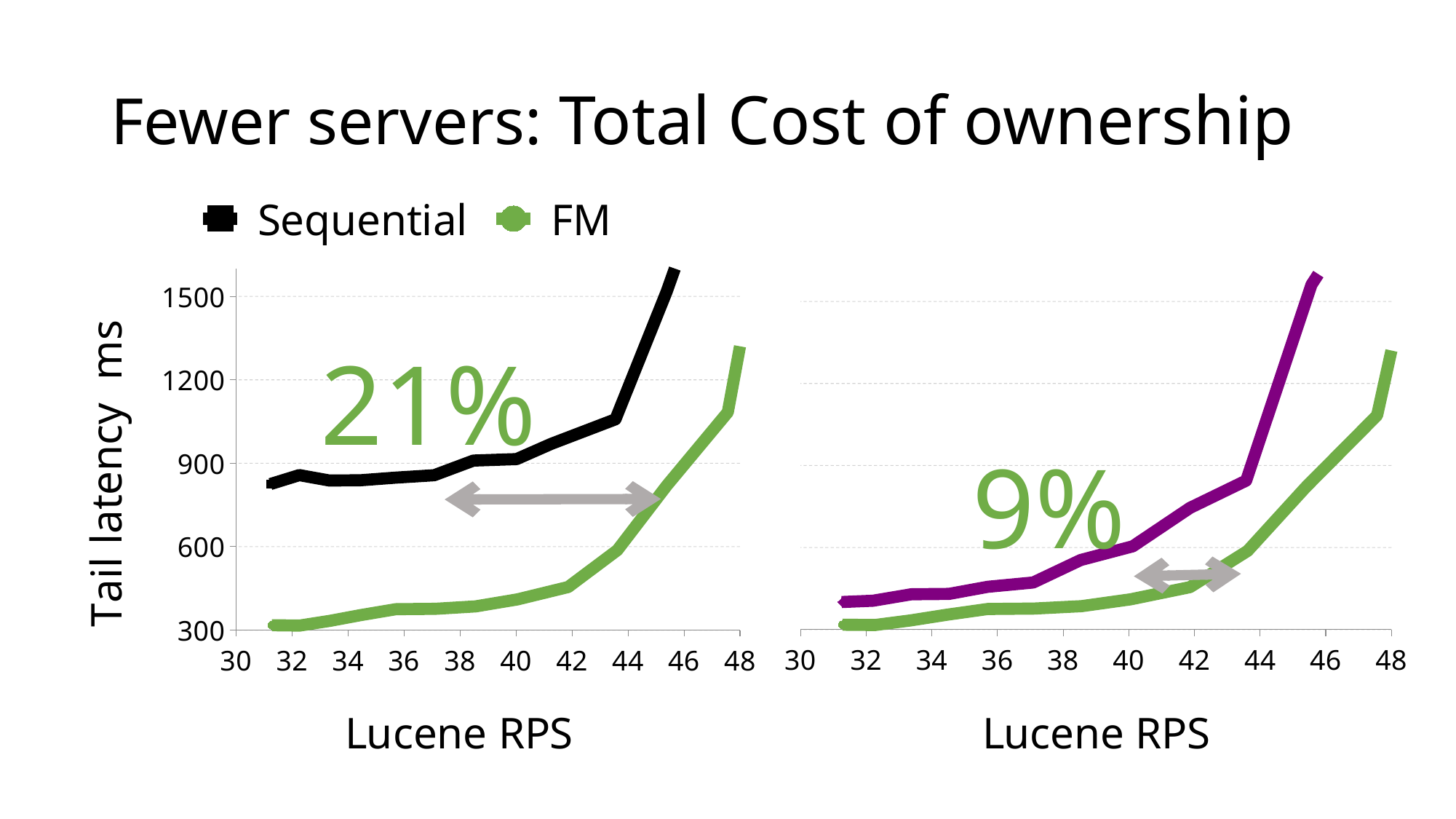
In the left chart, is the Sequential tail latency at 32 Lucene RPS greater or less than 600? greater What percentage is annotated on the right chart? 9% In the left chart, is the FM tail latency at 48 Lucene RPS greater or less than 1200? greater What kind of chart is the left chart on the slide? line chart In the right chart, is the purple line's tail latency at 46 Lucene RPS greater or less than 1500? greater In the right chart, does the FM tail latency rise or fall as Lucene RPS increases from 32 to 48? rise What percentage is annotated on the left chart? 21% In the left chart, at 40 Lucene RPS, which series has the higher tail latency, Sequential or FM? Sequential How many series does the legend list? 2